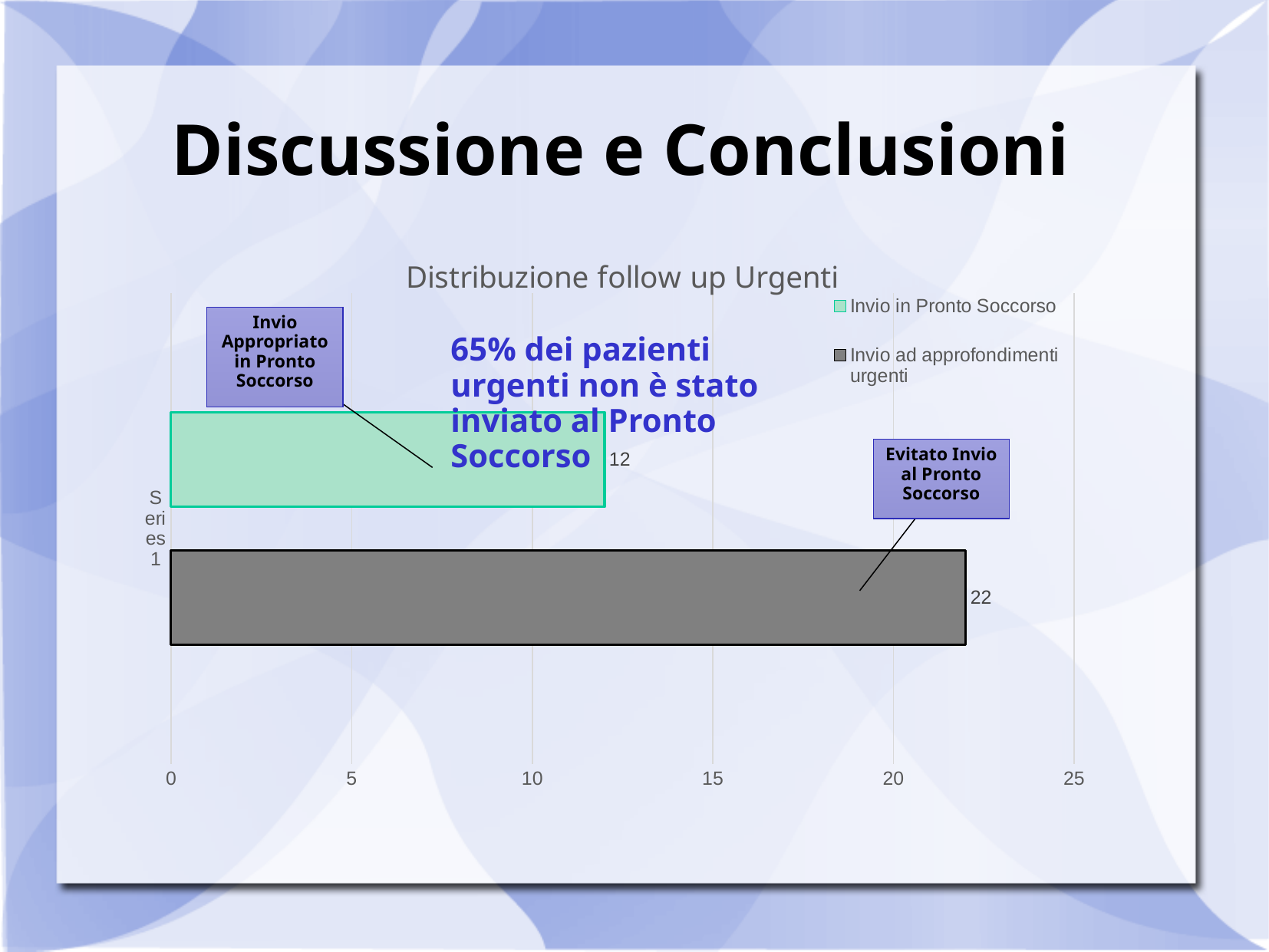
What kind of chart is shown on the slide? Bar chart Is the value for "Invio in Pronto Soccorso" greater or less than 15? less What colour is the bar for "Invio ad approfondimenti urgenti"? Grey Is the value for "Invio ad approfondimenti urgenti" greater or less than 20? greater What is the difference between the values for "Invio ad approfondimenti urgenti" and "Invio in Pronto Soccorso"? 10 What is the value for "Invio in Pronto Soccorso" in the chart? 12 What is the value for "Invio ad approfondimenti urgenti" in the chart? 22 Which series has the lowest value in the chart? Invio in Pronto Soccorso What is the title of the chart? Distribuzione follow up Urgenti How many series does the legend list? 2 Which series has the higher value, "Invio in Pronto Soccorso" or "Invio ad approfondimenti urgenti"? Invio ad approfondimenti urgenti What is the highest value shown on the x axis of the chart? 25